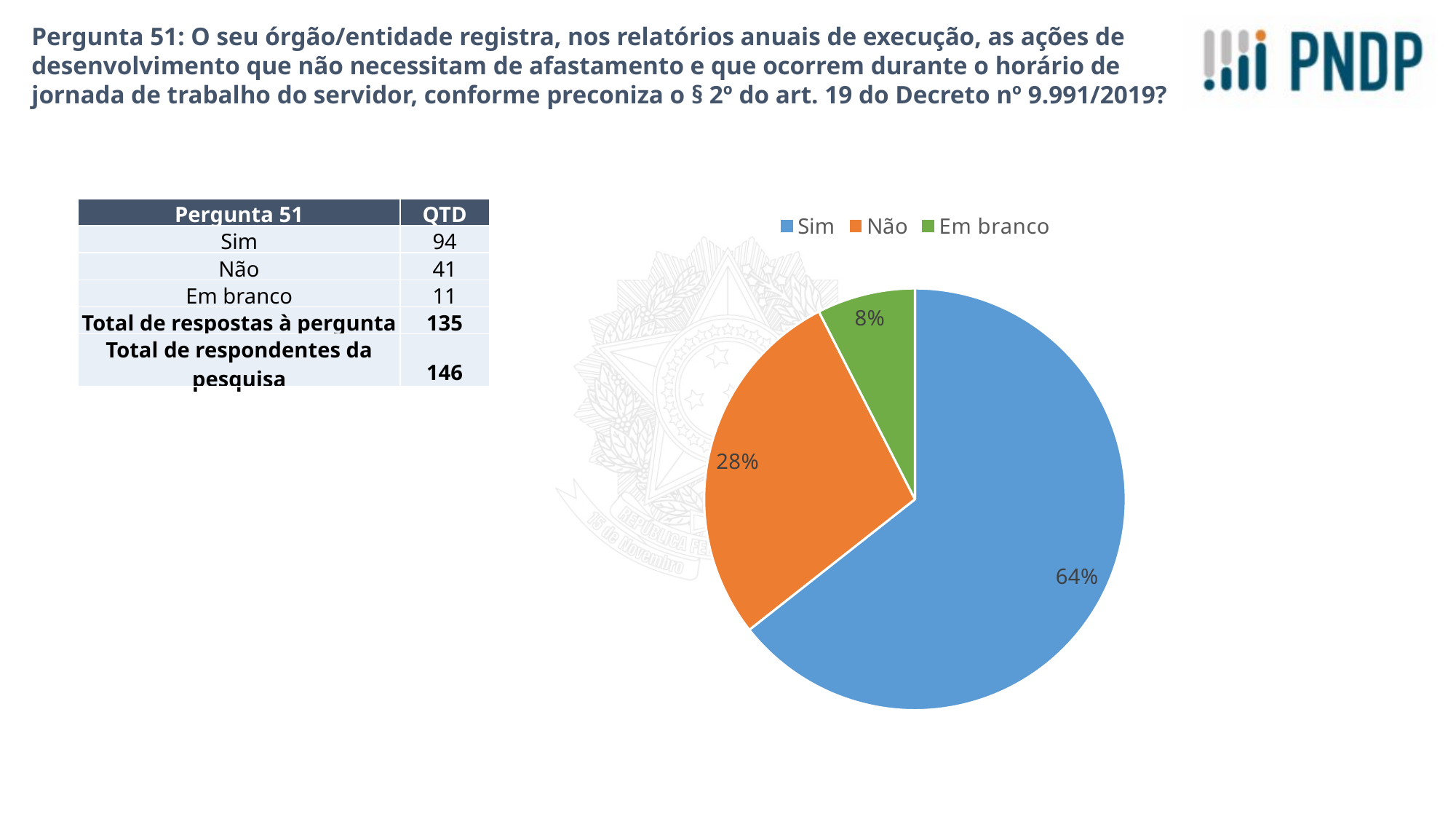
How many slices does the pie chart have? 3 Which category has the largest slice of the pie? Sim What share of the pie does the "Sim" slice represent? 64% What share of the pie does the "Em branco" slice represent? 8% How many entries does the legend list? 3 What kind of chart is shown on the slide? pie chart What colour is the "Em branco" slice in the pie chart? green Which slice is larger, "Não" or "Em branco"? Não Which category has the smallest slice of the pie? Em branco What is the difference in percentage points between the "Sim" slice and the "Não" slice? 36 What colour is the "Sim" slice in the pie chart? blue What share of the pie does the "Não" slice represent? 28%